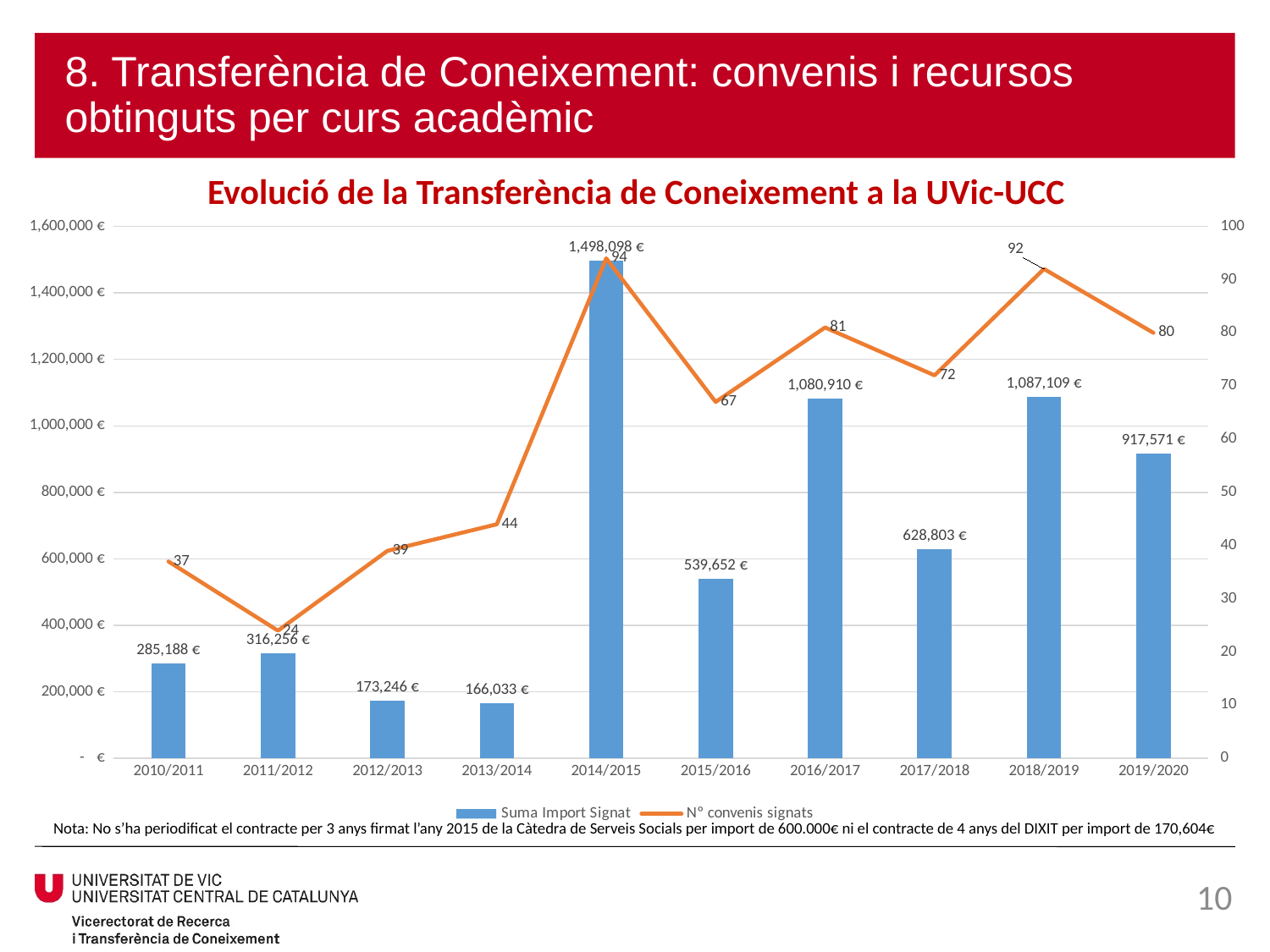
How many convenis signats (Nº convenis signats) were there in 2018/2019? 92 What is the difference in Nº convenis signats between 2018/2019 and 2019/2020? 12 Which academic year has the highest Suma Import Signat? 2014/2015 What is the Suma Import Signat value for 2019/2020? 917,571 € What is the difference in Suma Import Signat between 2018/2019 and 2016/2017? 6,199 € How many series does the legend list? 2 Which academic year has the lowest Suma Import Signat? 2013/2014 What is the Suma Import Signat value for 2014/2015? 1,498,098 € Which academic year has the lowest Nº convenis signats? 2011/2012 What is the title of the chart? Evolució de la Transferència de Coneixement a la UVic-UCC How many academic years are shown on the x axis? 10 Which year has a larger Suma Import Signat, 2015/2016 or 2017/2018? 2017/2018